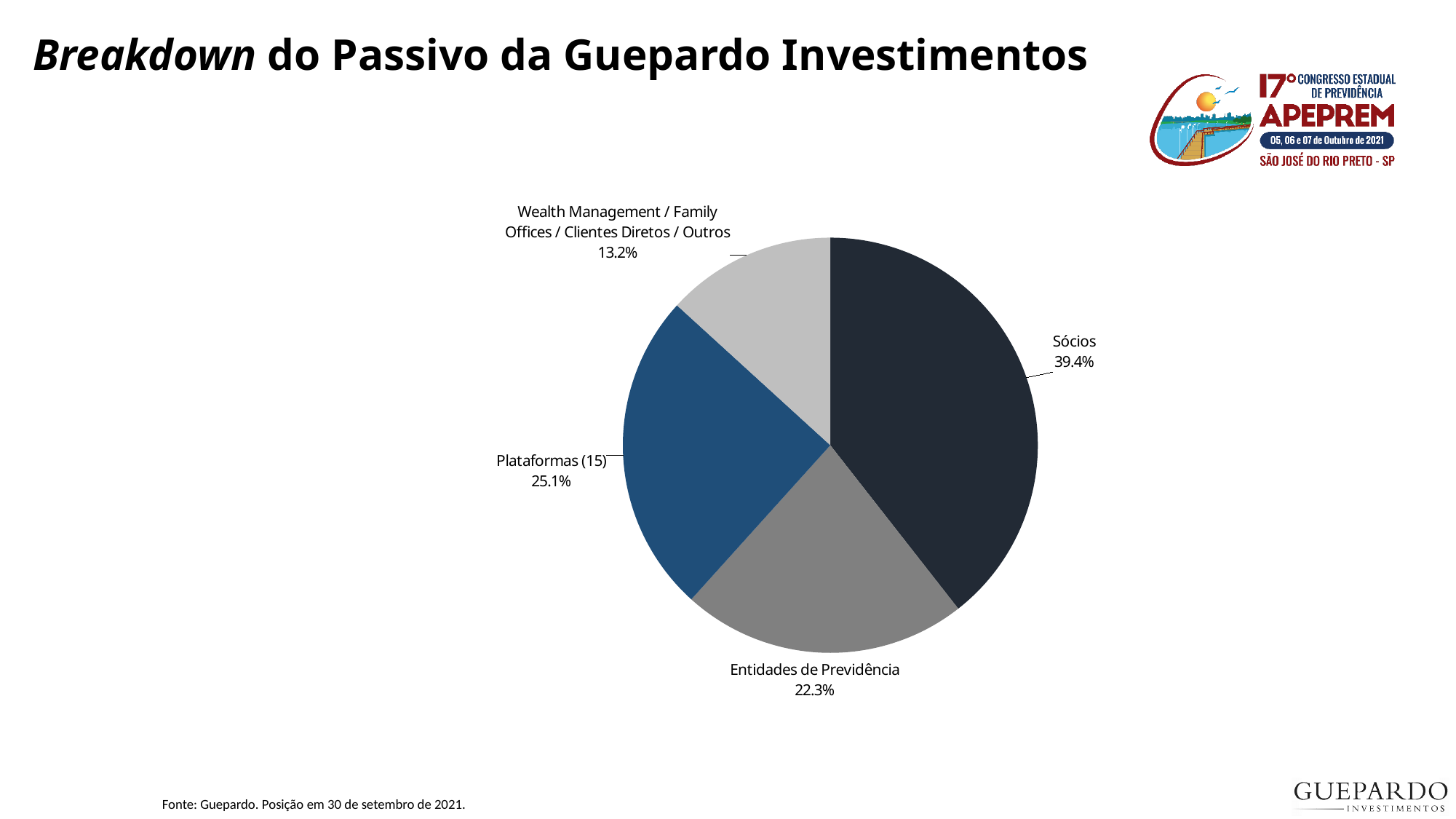
What is the title of the slide containing the chart? Breakdown do Passivo da Guepardo Investimentos Which category has the largest slice of the pie? Sócios What share of the pie does Sócios represent? 39.4% What kind of chart is shown on the slide? pie chart What is the difference in percentage points between Sócios and Entidades de Previdência? 17.1 Which is larger, Plataformas (15) or Entidades de Previdência? Plataformas (15) Which category has the smallest slice of the pie? Wealth Management / Family Offices / Clientes Diretos / Outros What is the value shown for Wealth Management / Family Offices / Clientes Diretos / Outros? 13.2% How many slices does the pie chart have? 4 What is the value shown for Plataformas (15)? 25.1% What is the value shown for Entidades de Previdência? 22.3% What is the difference in percentage points between Plataformas (15) and Wealth Management / Family Offices / Clientes Diretos / Outros? 11.9